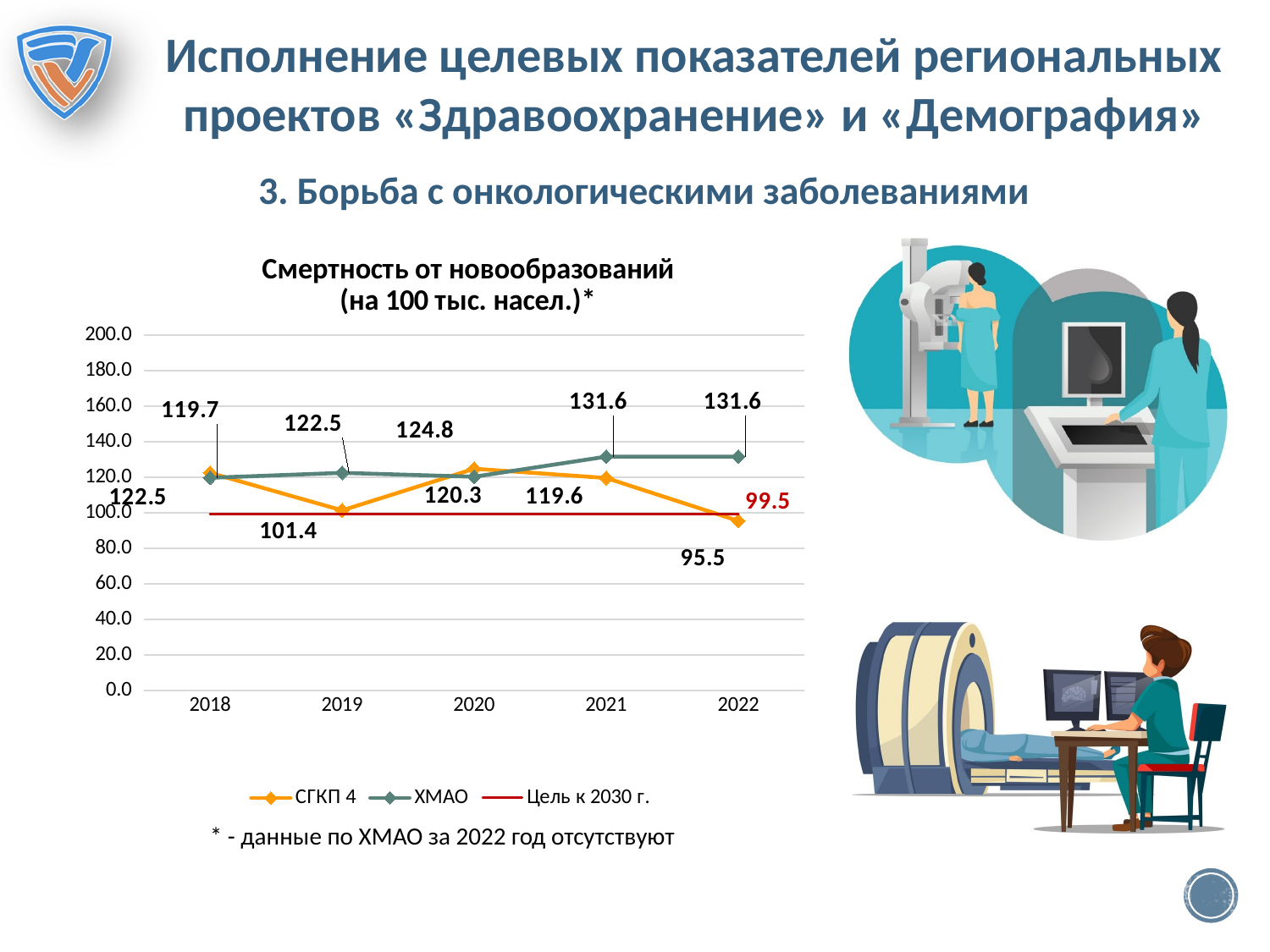
How many years are shown on the x axis of the chart? 5 How many series does the legend of the chart list? 3 In which year is the value for СГКП 4 the highest? 2020 In 2019, which series has the higher value, СГКП 4 or ХМАО? ХМАО In which year is the value for СГКП 4 the lowest? 2022 What is the value of the 'Цель к 2030 г.' line? 99.5 What is the value for СГКП 4 in 2022? 95.5 What is the difference between the ХМАО value and the СГКП 4 value in 2021? 12.0 Does the value for СГКП 4 rise or fall from 2021 to 2022? fall What is the value for СГКП 4 in 2019? 101.4 What is the value for ХМАО in 2021? 131.6 What kind of chart is shown on the slide? line chart